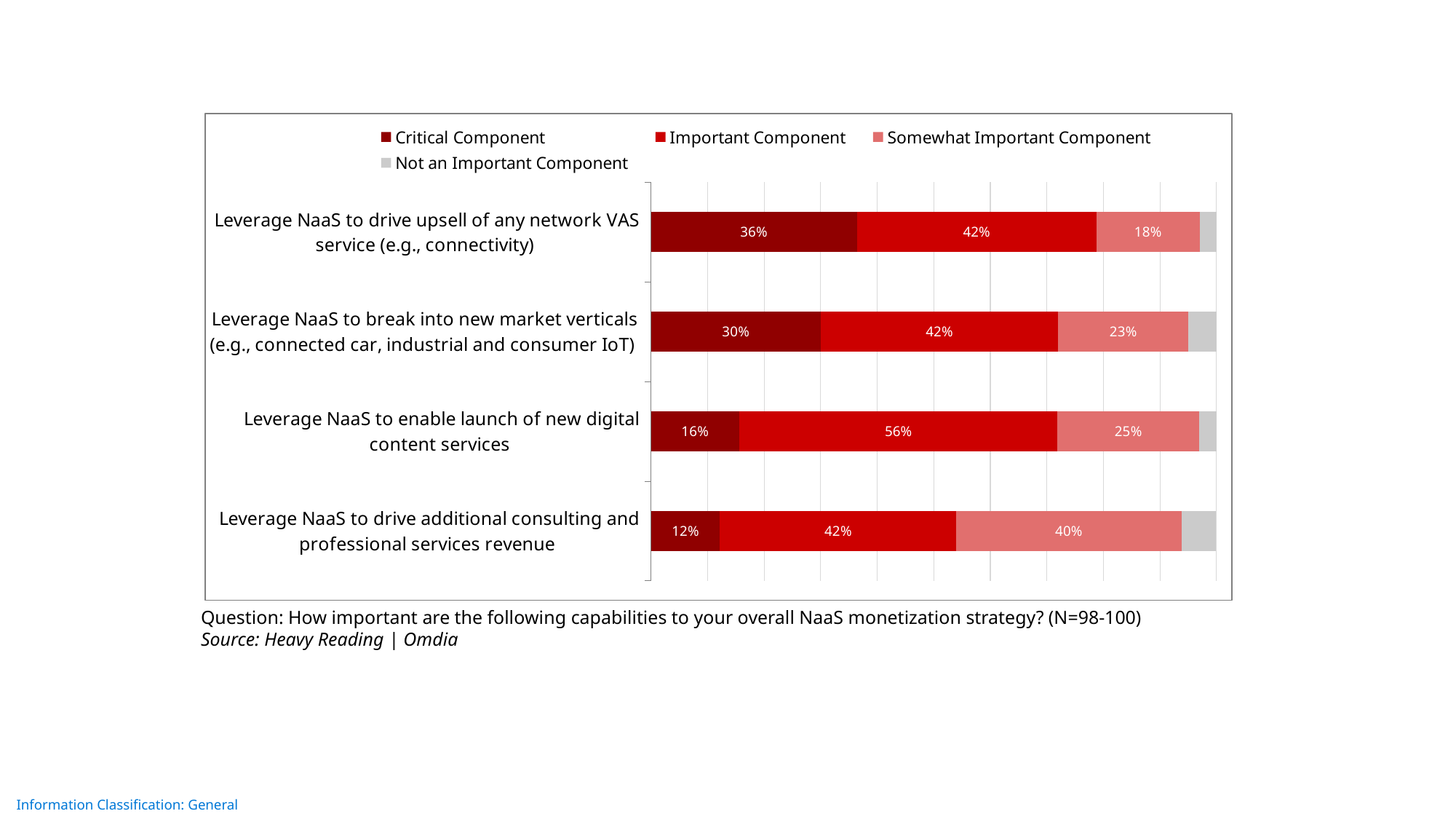
What is the Important Component value for 'Leverage NaaS to enable launch of new digital content services'? 56% What is the Critical Component value for 'Leverage NaaS to break into new market verticals (e.g., connected car, industrial and consumer IoT)'? 30% Which is larger: the Somewhat Important Component value for 'Leverage NaaS to break into new market verticals' or for 'Leverage NaaS to enable launch of new digital content services'? Leverage NaaS to enable launch of new digital content services How many capabilities (categories) are shown in the chart? 4 What is the Somewhat Important Component value for 'Leverage NaaS to drive additional consulting and professional services revenue'? 40% Which capability has the highest Critical Component percentage? Leverage NaaS to drive upsell of any network VAS service (e.g., connectivity) What is the difference between the Critical Component values for 'Leverage NaaS to drive upsell of any network VAS service' and 'Leverage NaaS to drive additional consulting and professional services revenue'? 24% Which capability has the highest Important Component percentage? Leverage NaaS to enable launch of new digital content services Which capability has the lowest Critical Component percentage? Leverage NaaS to drive additional consulting and professional services revenue How many series does the legend list? 4 What type of chart is shown on the slide? Stacked bar chart What percentage of respondents rated 'Leverage NaaS to drive upsell of any network VAS service (e.g., connectivity)' as a Critical Component? 36%